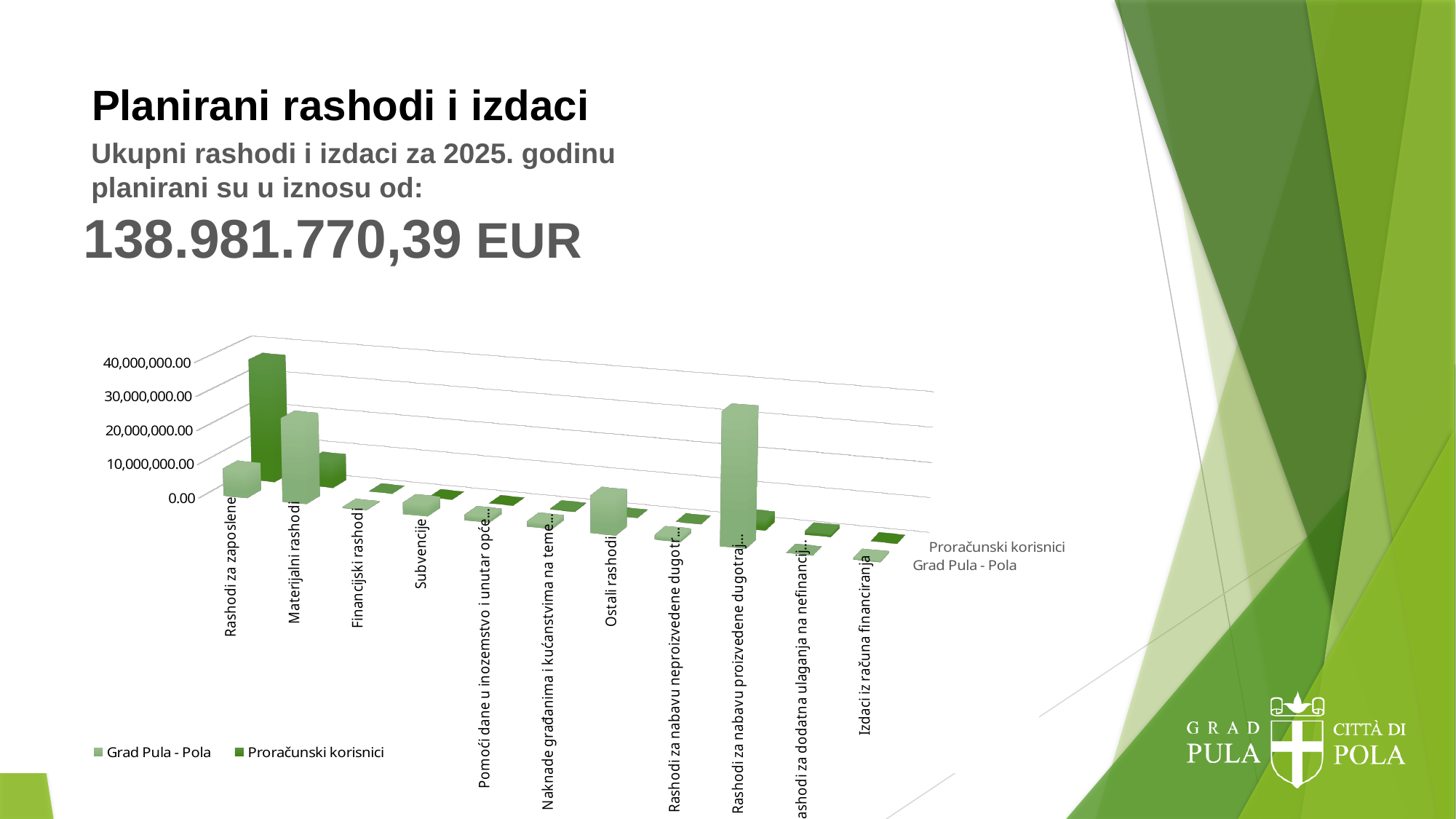
For Proračunski korisnici, which is larger: Rashodi za zaposlene or Materijalni rashodi? Rashodi za zaposlene For Grad Pula - Pola, which is larger: Rashodi za nabavu proizvedene dugotrajne imovine or Rashodi za zaposlene? Rashodi za nabavu proizvedene dugotrajne imovine For the Proračunski korisnici series, which category has the highest value? Rashodi za zaposlene What kind of chart is shown on the slide? bar chart How many series does the chart legend list? 2 Is the Proračunski korisnici value for Rashodi za zaposlene greater or less than 30,000,000.00? greater Is the Grad Pula - Pola value for Rashodi za zaposlene greater or less than 10,000,000.00? less How many expense categories are shown along the x axis of the chart? 11 Is the Grad Pula - Pola value for Rashodi za nabavu proizvedene dugotrajne imovine greater or less than 10,000,000.00? greater What is the highest value shown on the chart's vertical axis? 40,000,000.00 Which two series are listed in the chart legend? Grad Pula - Pola and Proračunski korisnici